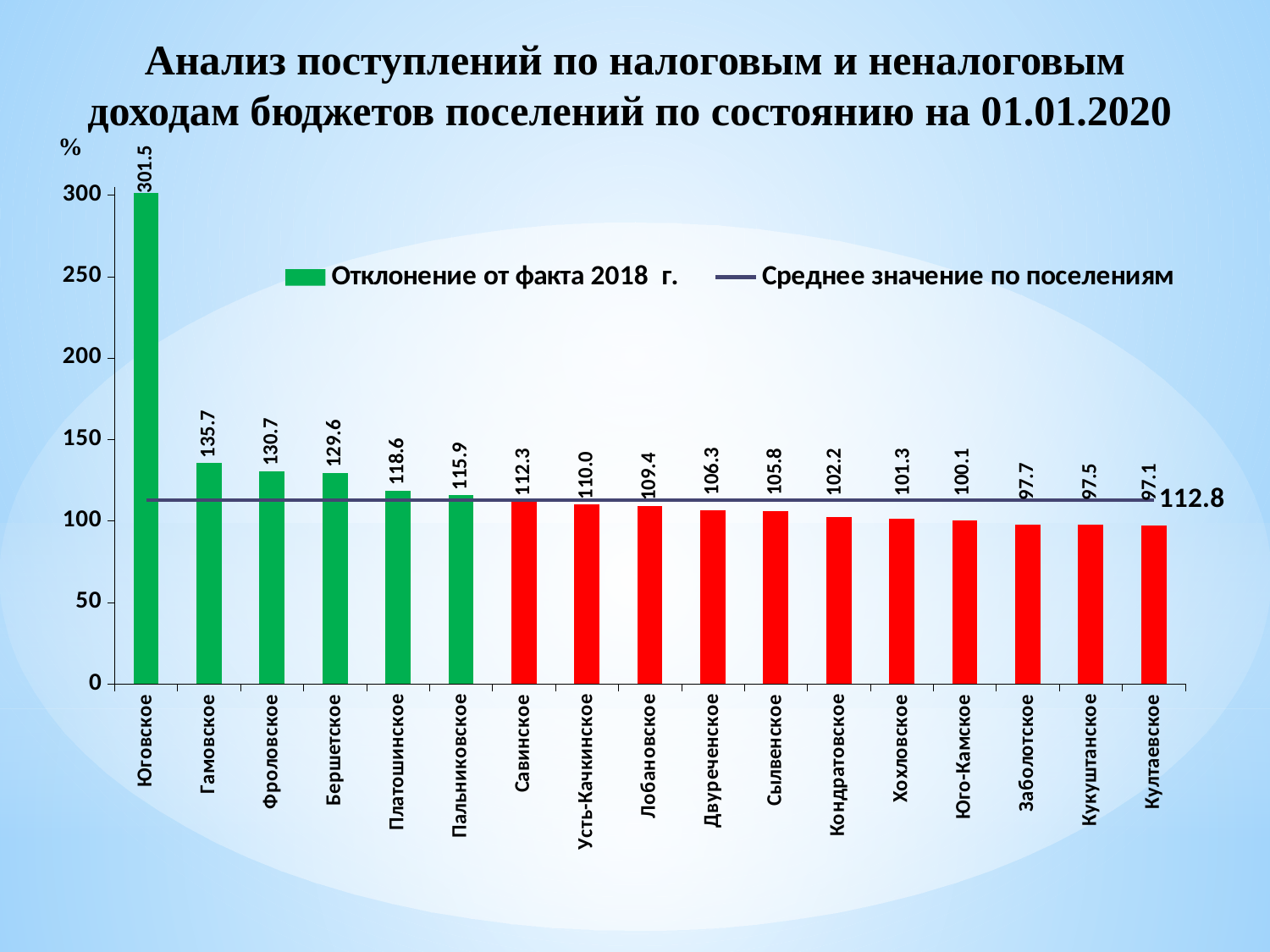
Is the value for Бершетское greater or less than 100? greater What is the value for Юговское? 301.5 Which is larger, the value for Платошинское or the value for Пальниковское? Платошинское What is the value for Сылвенское? 105.8 What is the value of the average line (Среднее значение по поселениям)? 112.8 What kind of chart is shown on the slide? combination bar and line chart What is the value for Заболотское? 97.7 Which settlement has the lowest value? Култаевское How many entries does the legend list? 2 How many settlements are shown on the x axis? 17 Which settlement has the highest value? Юговское What is the difference between the values for Гамовское and Фроловское? 5.0